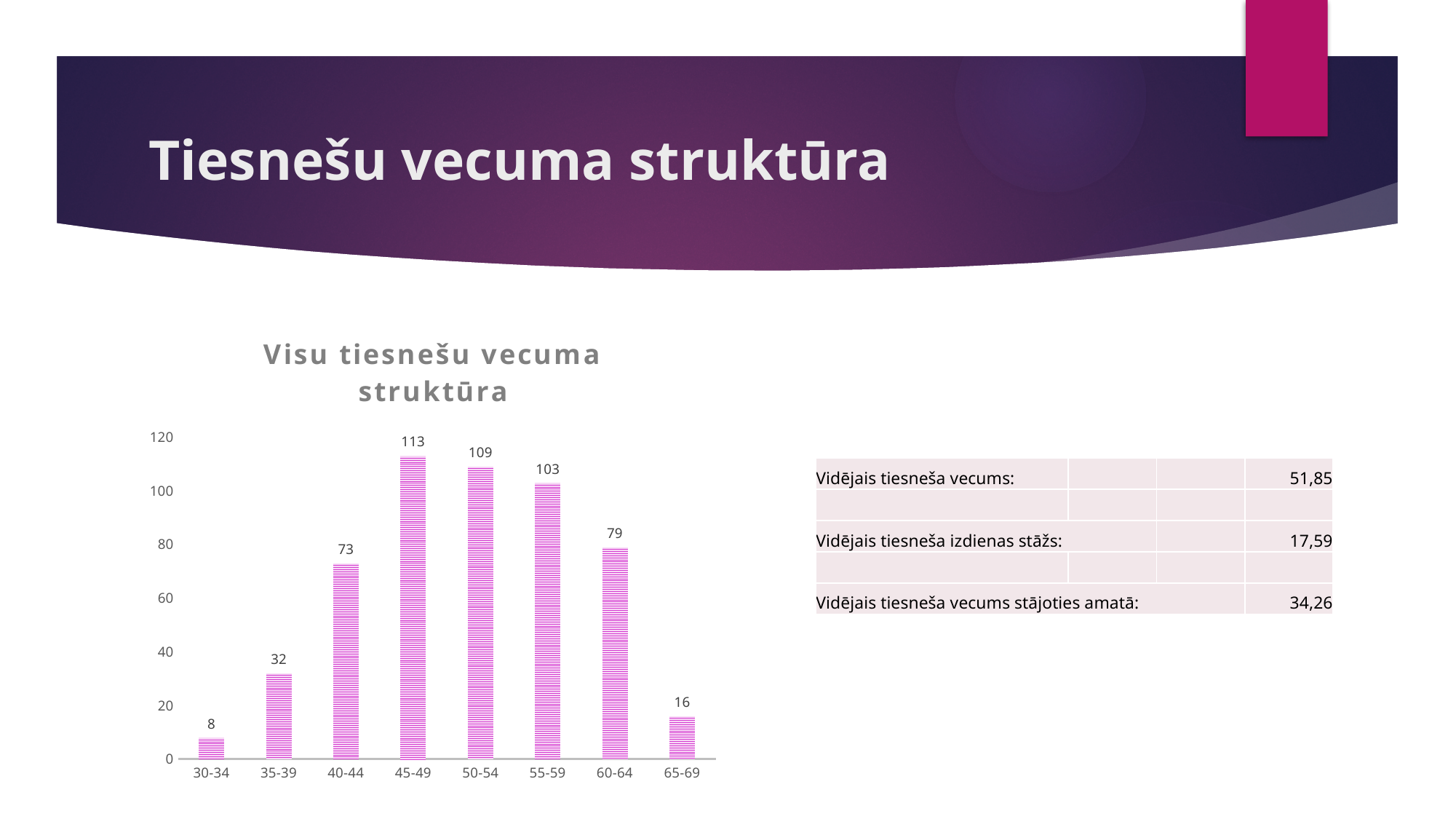
Which age group has the lowest value? 30-34 What is the value for the 45-49 age group? 113 What is the value for the 60-64 age group? 79 What is the difference between the values for 40-44 and 35-39? 41 Which is larger, the value for 65-69 or the value for 35-39? 35-39 How many age groups are shown on the x axis? 8 Which age group has the highest value? 45-49 What is the title of the chart? Visu tiesnešu vecuma struktūra Is the value for 60-64 greater or less than 60? greater What is the value for the 30-34 age group? 8 What is the difference between the values for 50-54 and 55-59? 6 What kind of chart is shown on the slide? bar chart